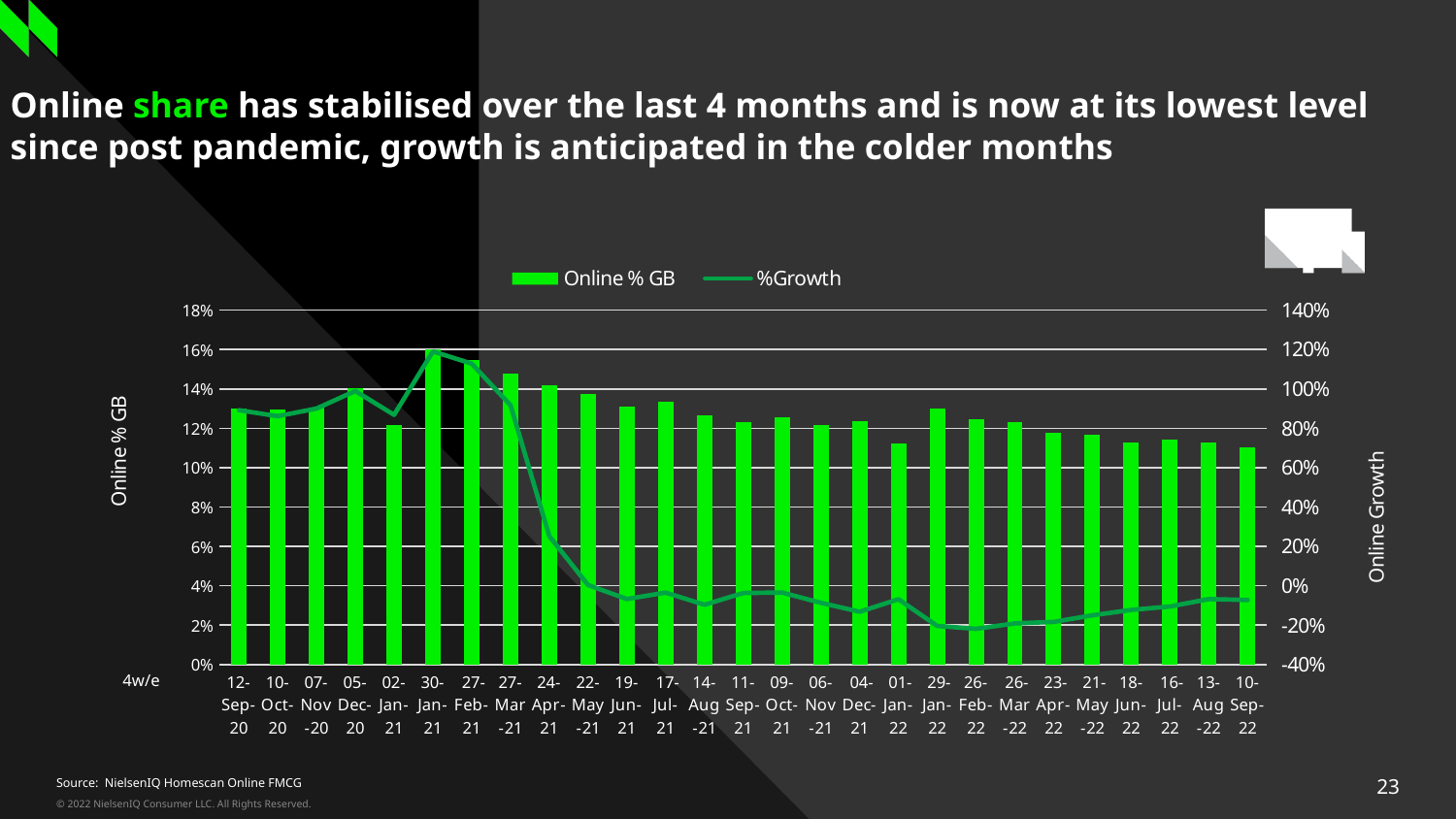
Which period has the highest Online % GB bar? 30-Jan-21 Is the %Growth value for 26-Feb-22 greater or less than 0%? less What are the two series named in the chart legend? Online % GB and %Growth Is the %Growth value for 30-Jan-21 greater or less than 100%? greater Does the %Growth line rise or fall between 30-Jan-21 and 19-Jun-21? fall Which has the larger Online % GB bar, 27-Mar-21 or 09-Oct-21? 27-Mar-21 How many series does the chart legend list? 2 What kind of chart is shown on the slide? A combined bar and line chart Is the Online % GB value for 30-Jan-21 greater or less than 14%? greater How many 4-week periods are plotted along the x axis? 27 What is the title of the left-hand vertical axis? Online % GB